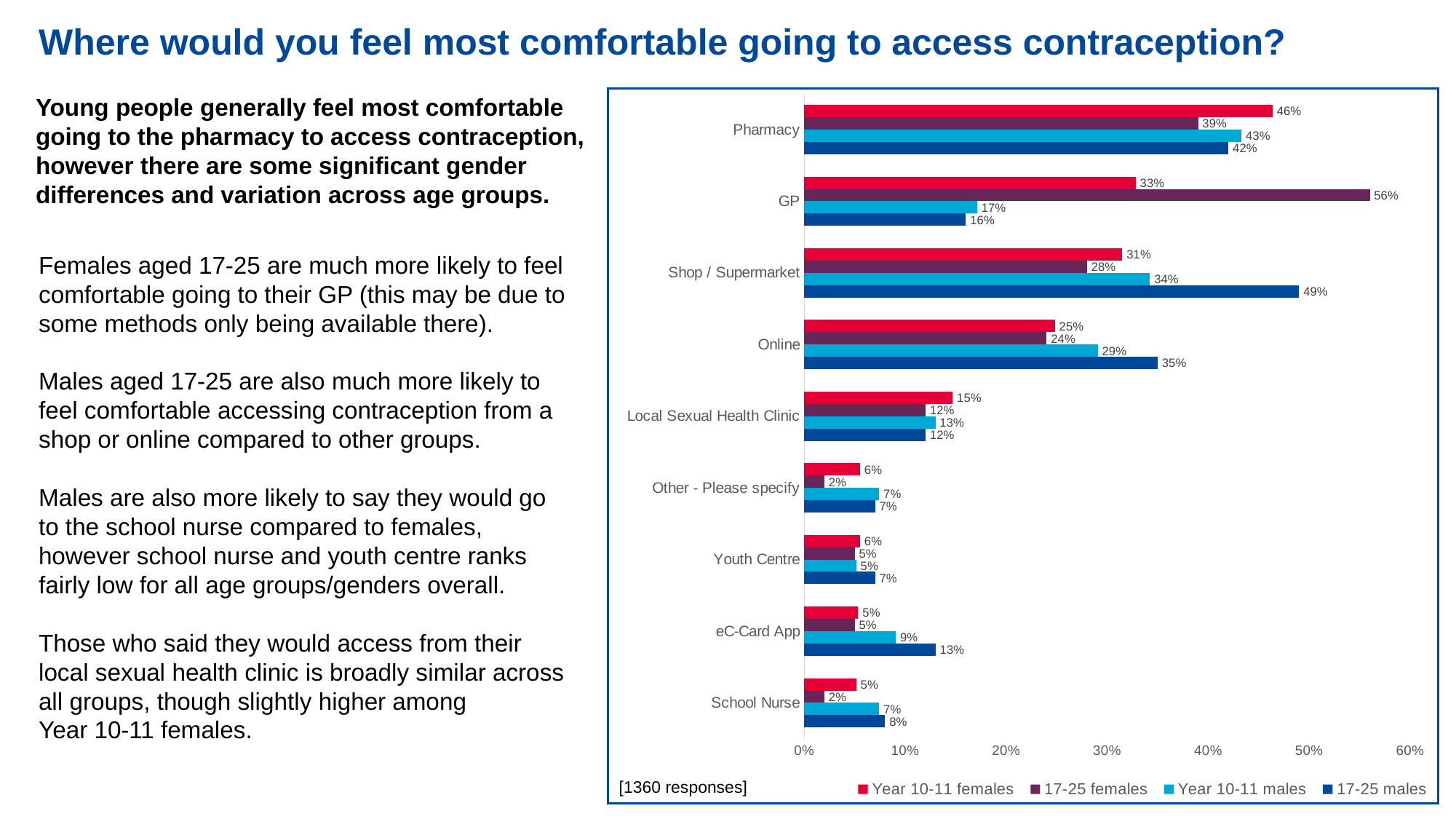
What is the value for 17-25 males for the eC-Card App? 13% Which location has the lowest value for 17-25 females? Other - Please specify and School Nurse (both 2%) How many series does the legend list? 4 For Online, which group has the larger value: 17-25 males or Year 10-11 males? 17-25 males Which location has the highest value for 17-25 males? Shop / Supermarket What percentage of Year 10-11 females chose Pharmacy? 46% What type of chart is shown on the slide? Bar chart How many locations (categories) are shown on the chart? 9 What percentage of 17-25 females said they would feel most comfortable going to the GP? 56% How many responses does the chart note say it is based on? 1360 responses What is the difference between 17-25 females and Year 10-11 males for GP? 39 percentage points What percentage of 17-25 males chose Shop / Supermarket? 49%